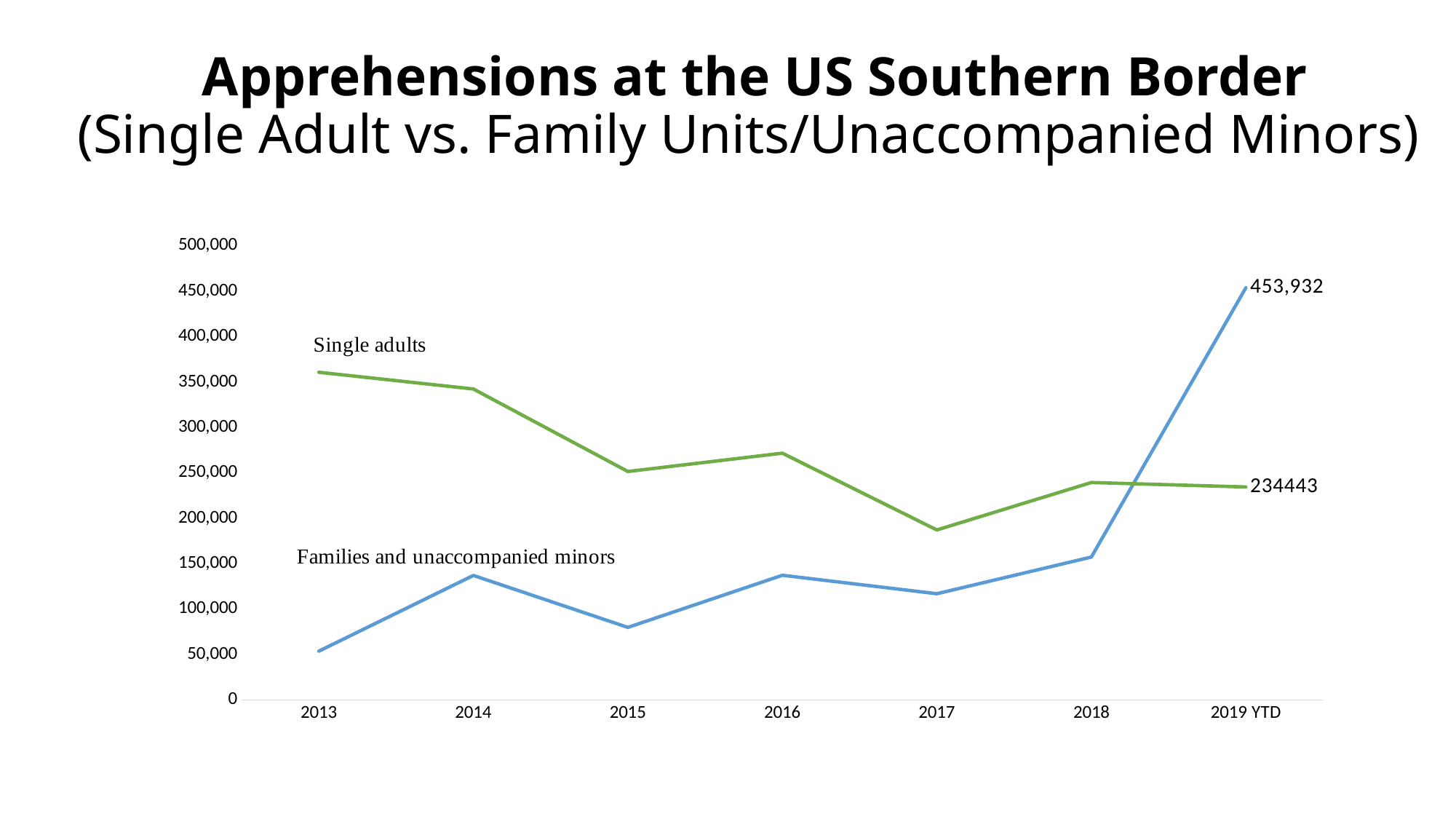
In which year is the Single adults series at its lowest? 2017 Is the value for Single adults in 2017 greater or less than 250,000? less What is the difference between the Families and unaccompanied minors value and the Single adults value in 2019 YTD? 219,489 In 2019 YTD, which series has the larger value: Single adults or Families and unaccompanied minors? Families and unaccompanied minors What kind of chart is shown on the slide? line chart What is the value for Single adults in 2019 YTD? 234443 What is the value for Families and unaccompanied minors in 2019 YTD? 453,932 How many data series are plotted on the chart? 2 How many years are shown on the x axis? 7 Is the value for Single adults in 2013 greater or less than 300,000? greater Is the value for Families and unaccompanied minors in 2013 greater or less than 100,000? less In which year is the Single adults series at its highest? 2013